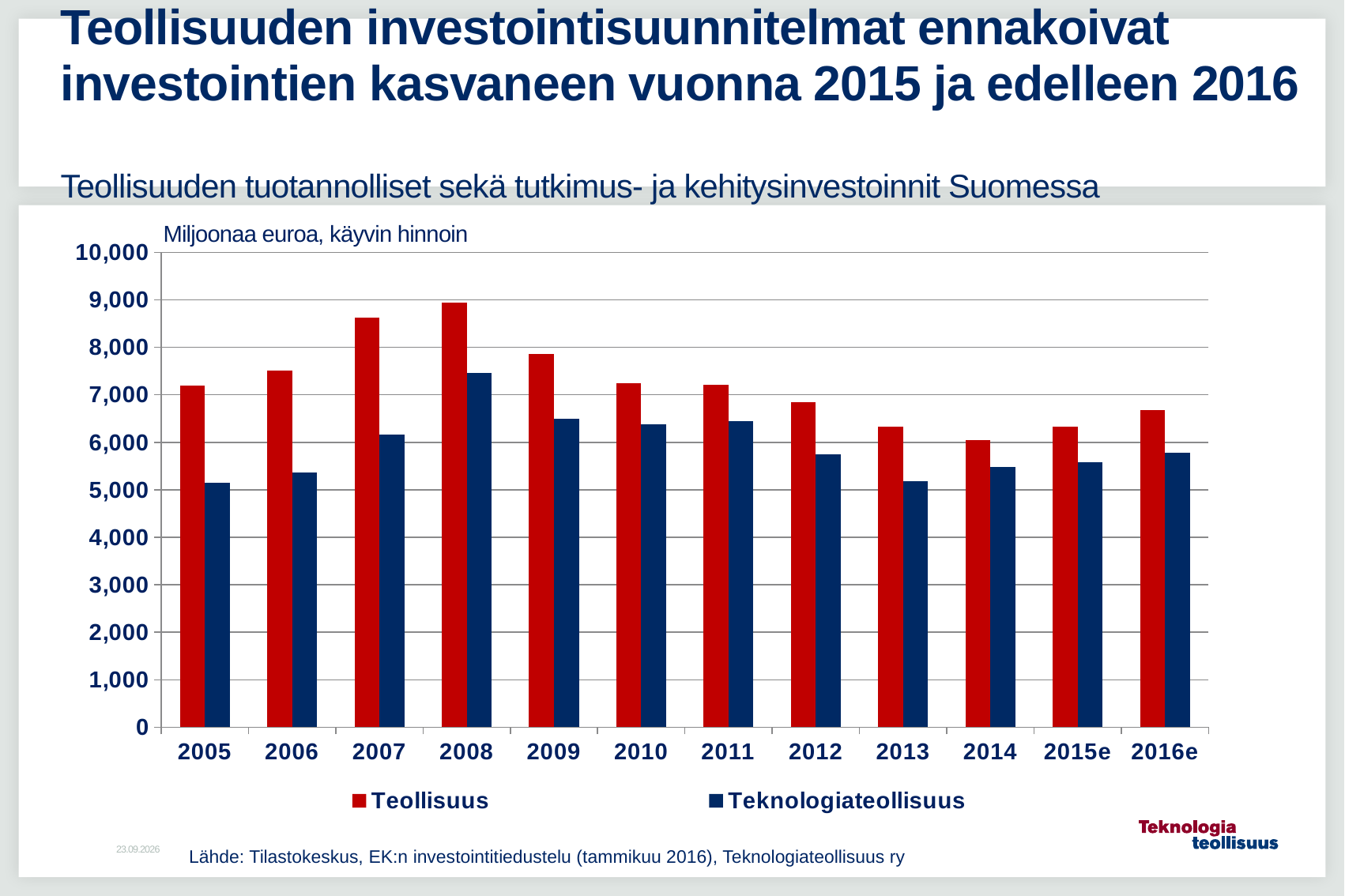
In which year is the Teollisuus value highest? 2008 What unit is stated above the y axis of the chart? Miljoonaa euroa, käyvin hinnoin What kind of chart is shown on the slide? bar chart Which is larger, the Teollisuus value for 2007 or for 2009? 2007 How many series does the legend list? 2 Does the Teollisuus series rise or fall from 2008 to 2014? fall Is the Teknologiateollisuus value for 2012 greater or less than 6,000? less How many years (categories) are shown on the x axis? 12 Is the Teollisuus value for 2008 greater or less than 8,000? greater In which year is the Teknologiateollisuus value highest? 2008 In which year is the Teollisuus value lowest? 2014 Is the Teknologiateollisuus value for 2008 greater or less than 7,000? greater